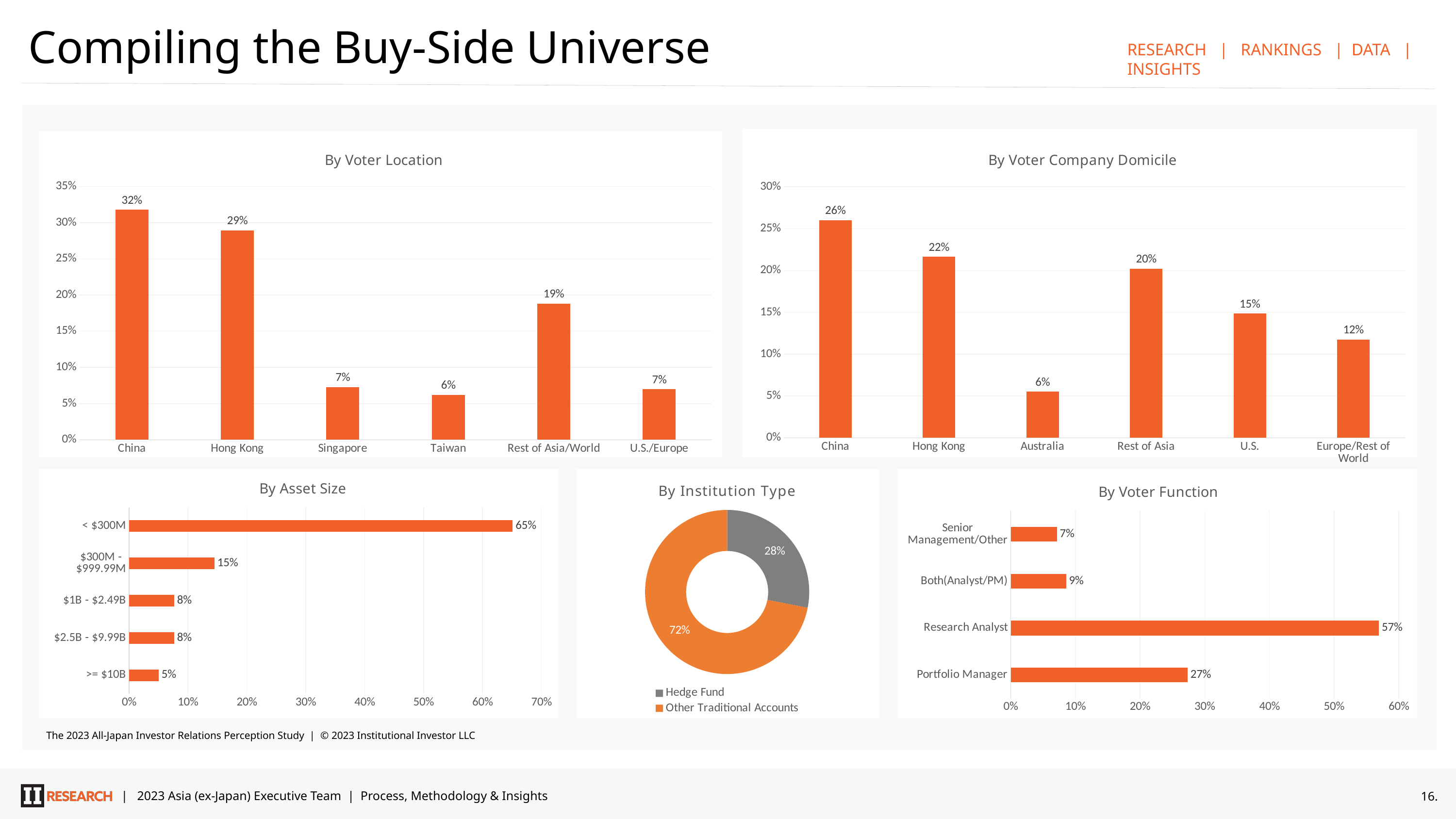
In the 'By Voter Function' chart, what is the difference between Research Analyst and Both(Analyst/PM)? 48% In the 'By Voter Location' chart, what is the value for Hong Kong? 29% In the 'By Voter Company Domicile' chart, what is the value for Australia? 6% In the 'By Asset Size' chart, which is larger: $300M - $999.99M or >= $10B? $300M - $999.99M In the 'By Voter Function' chart, what is the value for Portfolio Manager? 27% In the 'By Asset Size' chart, what is the value for < $300M? 65% In the 'By Voter Location' chart, which category has the highest value? China In the 'By Voter Company Domicile' chart, how many categories are shown? 6 In the 'By Voter Company Domicile' chart, which category has the lowest value? Australia In the 'By Voter Location' chart, what is the difference between China and Rest of Asia/World? 13% What kind of chart is 'By Institution Type'? Doughnut chart In the 'By Institution Type' chart, what share is Hedge Fund? 28%